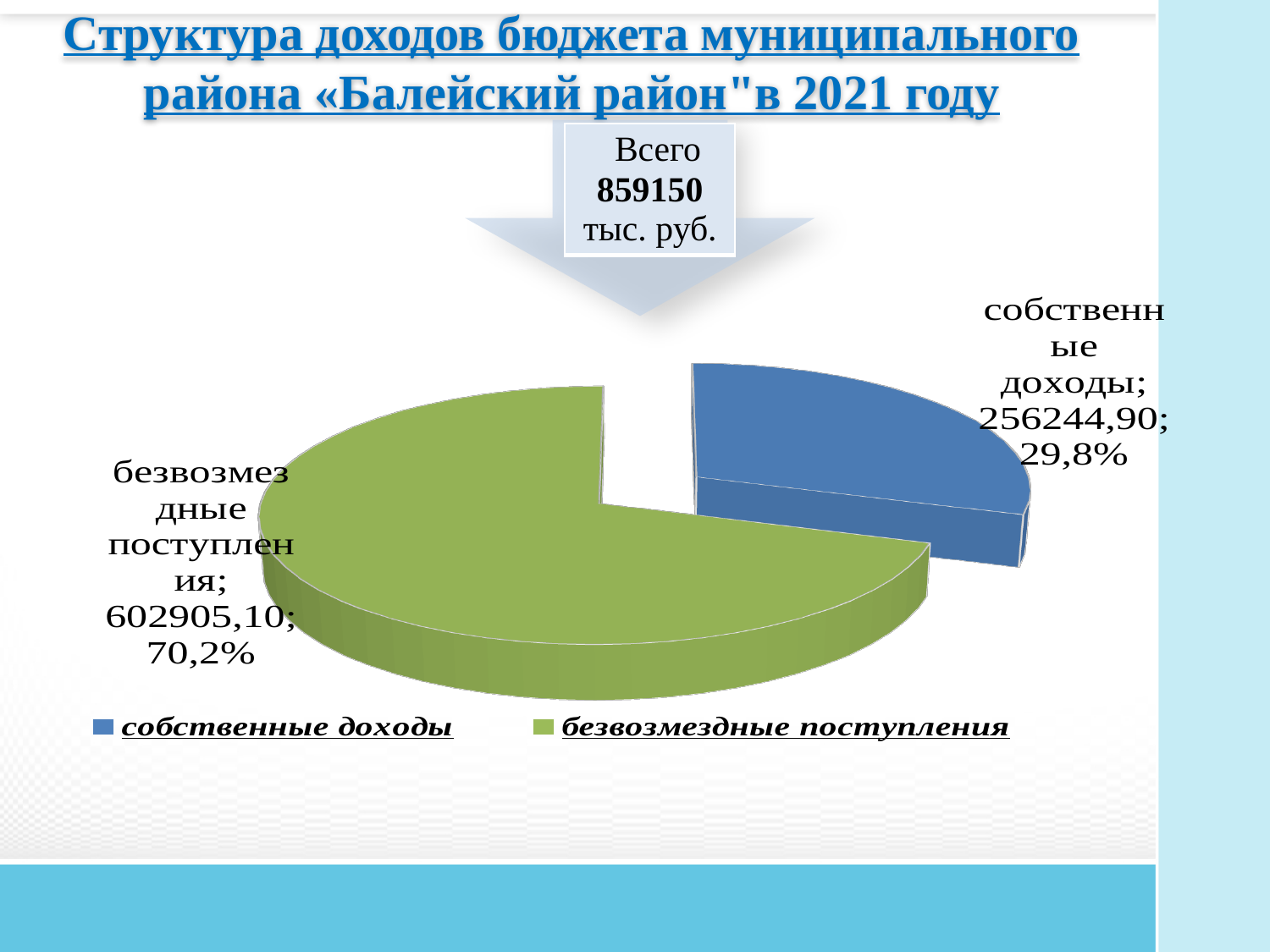
What is the total of all budget revenues shown on the slide, in тыс. руб.? 859150 Which colour represents собственные доходы in the legend? blue What share of the pie does собственные доходы represent? 29,8% Which category has the smallest slice of the pie? собственные доходы What is the difference between the values for безвозмездные поступления and собственные доходы? 346660,20 What kind of chart is shown on the slide? pie chart How many slices does the pie chart have? 2 What is the value for безвозмездные поступления? 602905,10 What is the value for собственные доходы? 256244,90 Which is larger: собственные доходы or безвозмездные поступления? безвозмездные поступления What share of the pie does безвозмездные поступления represent? 70,2% Which category has the largest slice of the pie? безвозмездные поступления